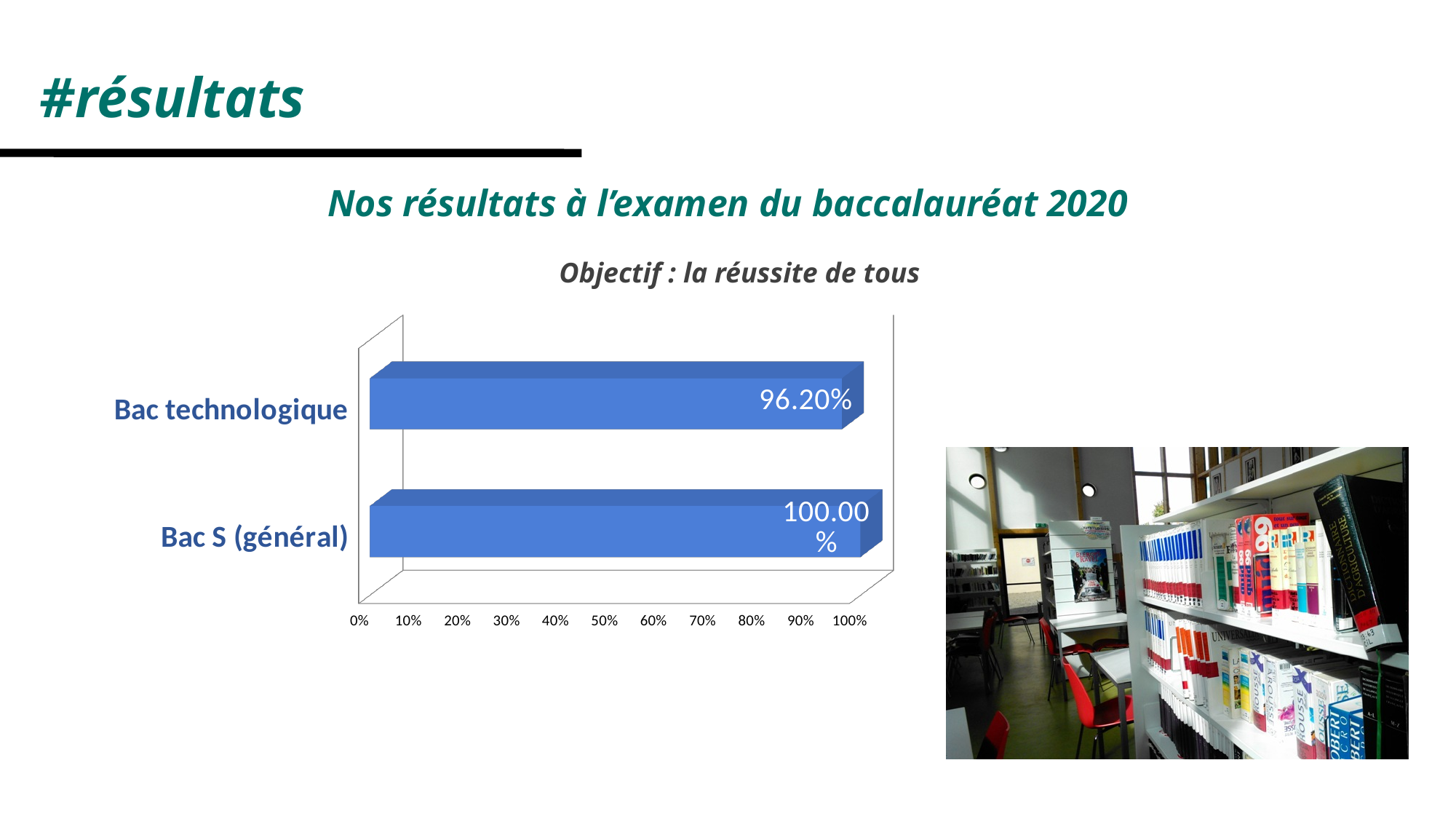
Is the value for Bac technologique greater or less than 90%? greater What is the highest value shown on the x axis? 100% What is the value for Bac technologique? 96.20% Which category has the highest value? Bac S (général) How many categories are shown in the chart? 2 What is the value for Bac S (général)? 100.00% What is the title of the chart? Objectif : la réussite de tous Which category has the lowest value? Bac technologique Which is larger, the value for Bac technologique or the value for Bac S (général)? Bac S (général) What kind of chart is shown on the slide? bar chart What is the difference between the values for Bac S (général) and Bac technologique? 3.80%